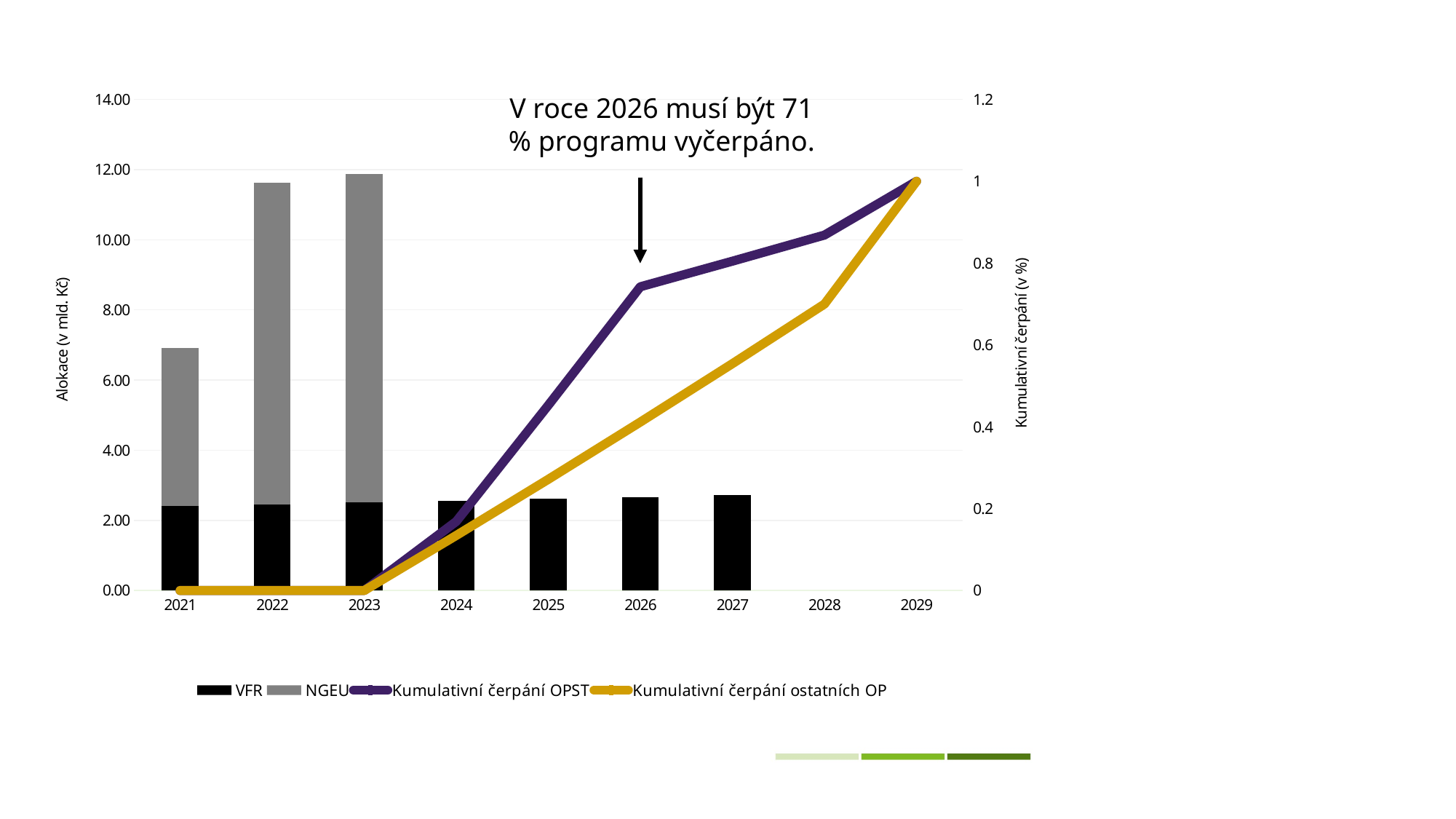
What is the value of Kumulativní čerpání OPST in 2029? 1 Is the value of Kumulativní čerpání OPST in 2026 greater or less than 0.6? greater Does the Kumulativní čerpání OPST line rise or fall from 2023 to 2029? rise What is the value of Kumulativní čerpání ostatních OP in 2021? 0 What is the title of the left vertical axis? Alokace (v mld. Kč) How many series does the legend list? 4 Is the total height of the stacked bar for 2023 greater or less than 10.00? greater Is the value of Kumulativní čerpání ostatních OP in 2026 greater or less than 0.6? less What kind of chart is this? Combined bar and line chart In 2026, which line is higher: Kumulativní čerpání OPST or Kumulativní čerpání ostatních OP? Kumulativní čerpání OPST How many years are shown on the x axis? 9